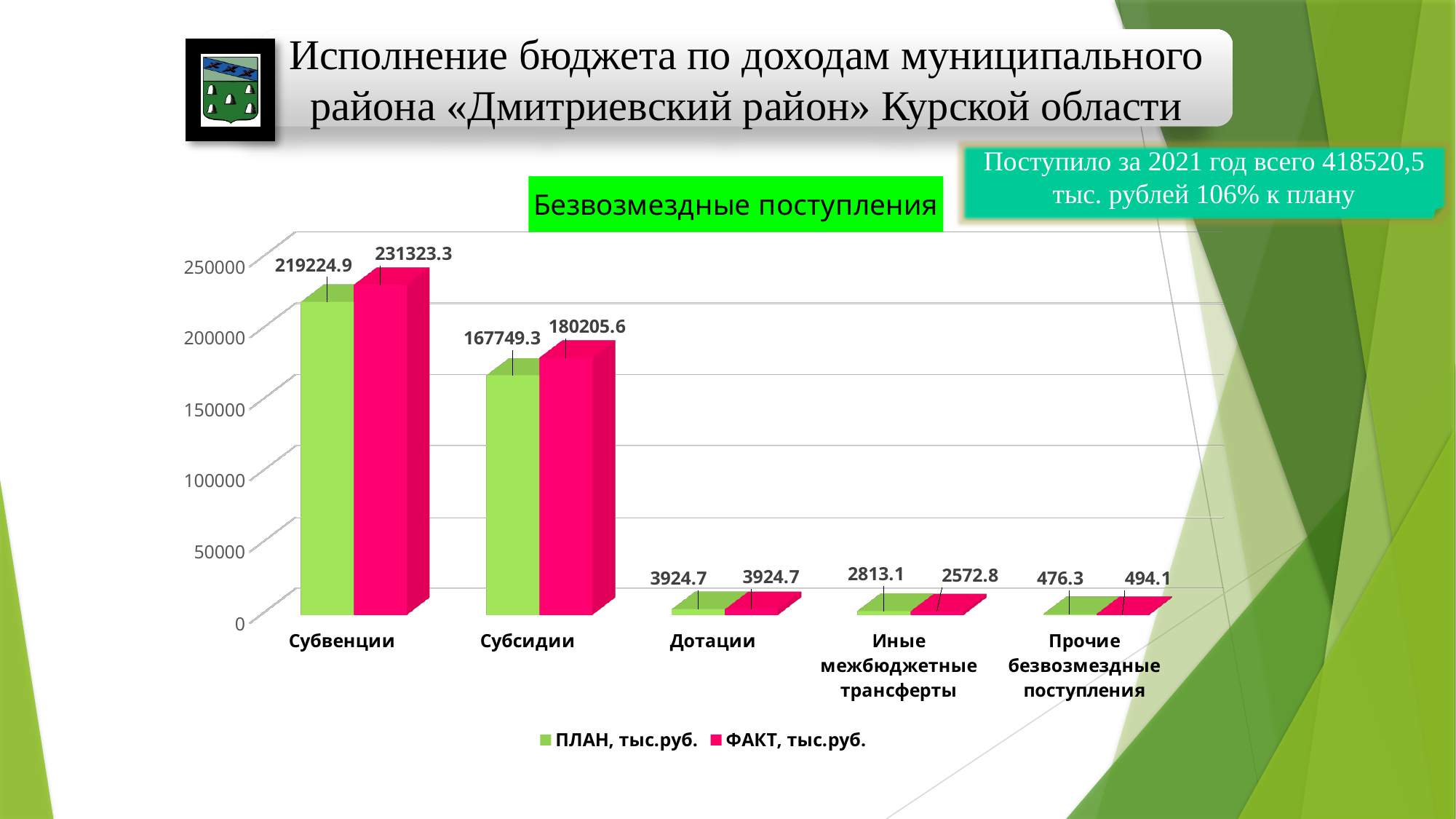
Which category has the highest ФАКТ value? Субвенции Which category has the lowest ПЛАН value? Прочие безвозмездные поступления Which is larger for Субсидии, the ПЛАН value or the ФАКТ value? ФАКТ What is the ПЛАН value for Прочие безвозмездные поступления? 476.3 What is the ПЛАН value for Субвенции? 219224.9 What is the ФАКТ value for Субсидии? 180205.6 What is the ФАКТ value for Иные межбюджетные трансферты? 2572.8 How many series does the legend list? 2 What is the difference between the ПЛАН and ФАКТ values for Иные межбюджетные трансферты? 240.3 What type of chart is shown on the slide? Bar chart What is the difference between the ФАКТ and ПЛАН values for Субвенции? 12098.4 How many categories are shown on the x axis? 5